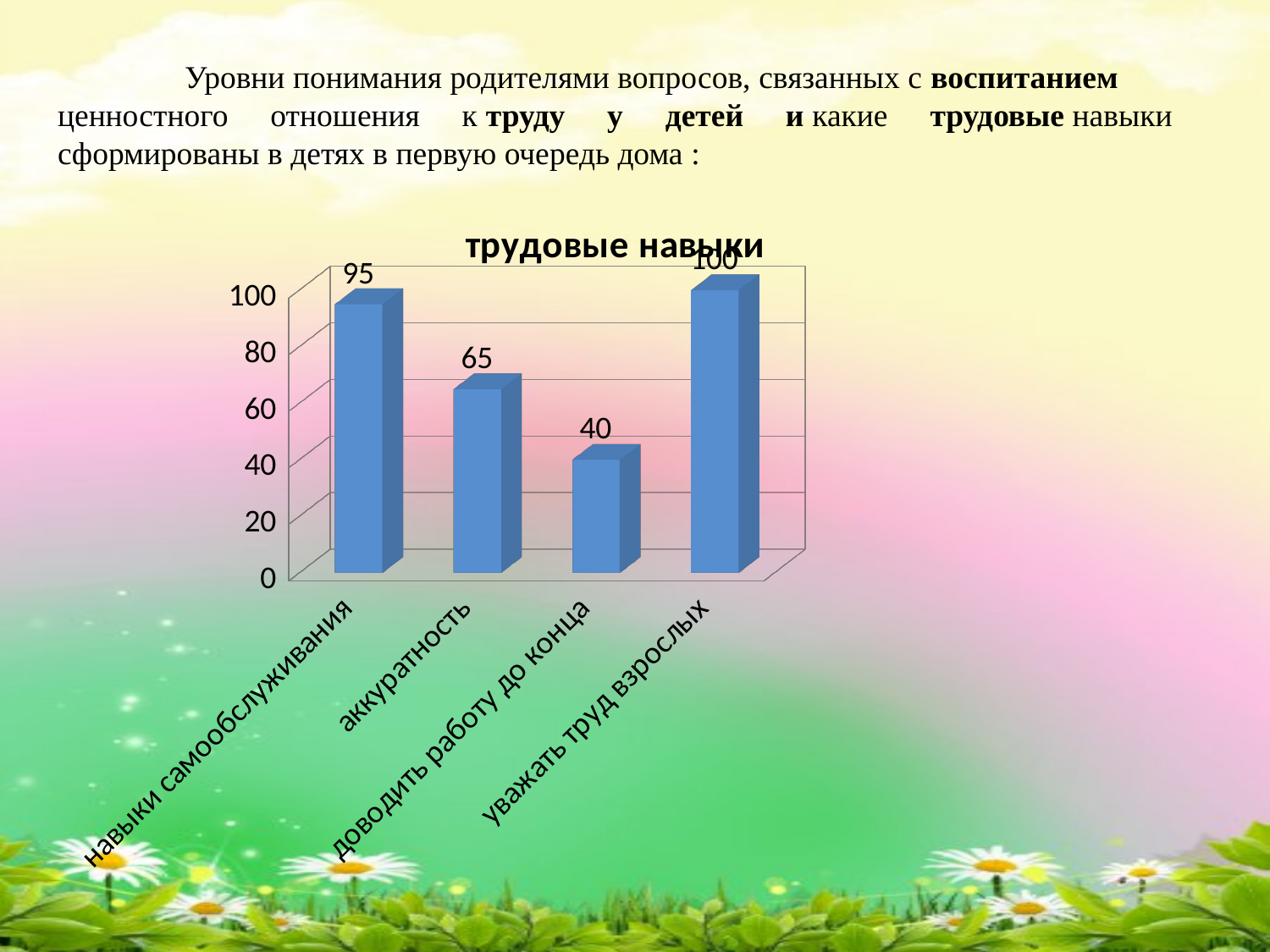
What is the value for доводить работу до конца? 40 What is the value for аккуратность? 65 What kind of chart is shown on the slide? bar chart Which category has the lowest value? доводить работу до конца Which category has the highest value? уважать труд взрослых What is the value for уважать труд взрослых? 100 What is the title of the chart? трудовые навыки How many categories are shown in the chart? 4 Which is larger, the value for аккуратность or the value for доводить работу до конца? аккуратность What is the value for навыки самообслуживания? 95 What is the difference between the values for навыки самообслуживания and аккуратность? 30 What is the difference between the values for уважать труд взрослых and доводить работу до конца? 60